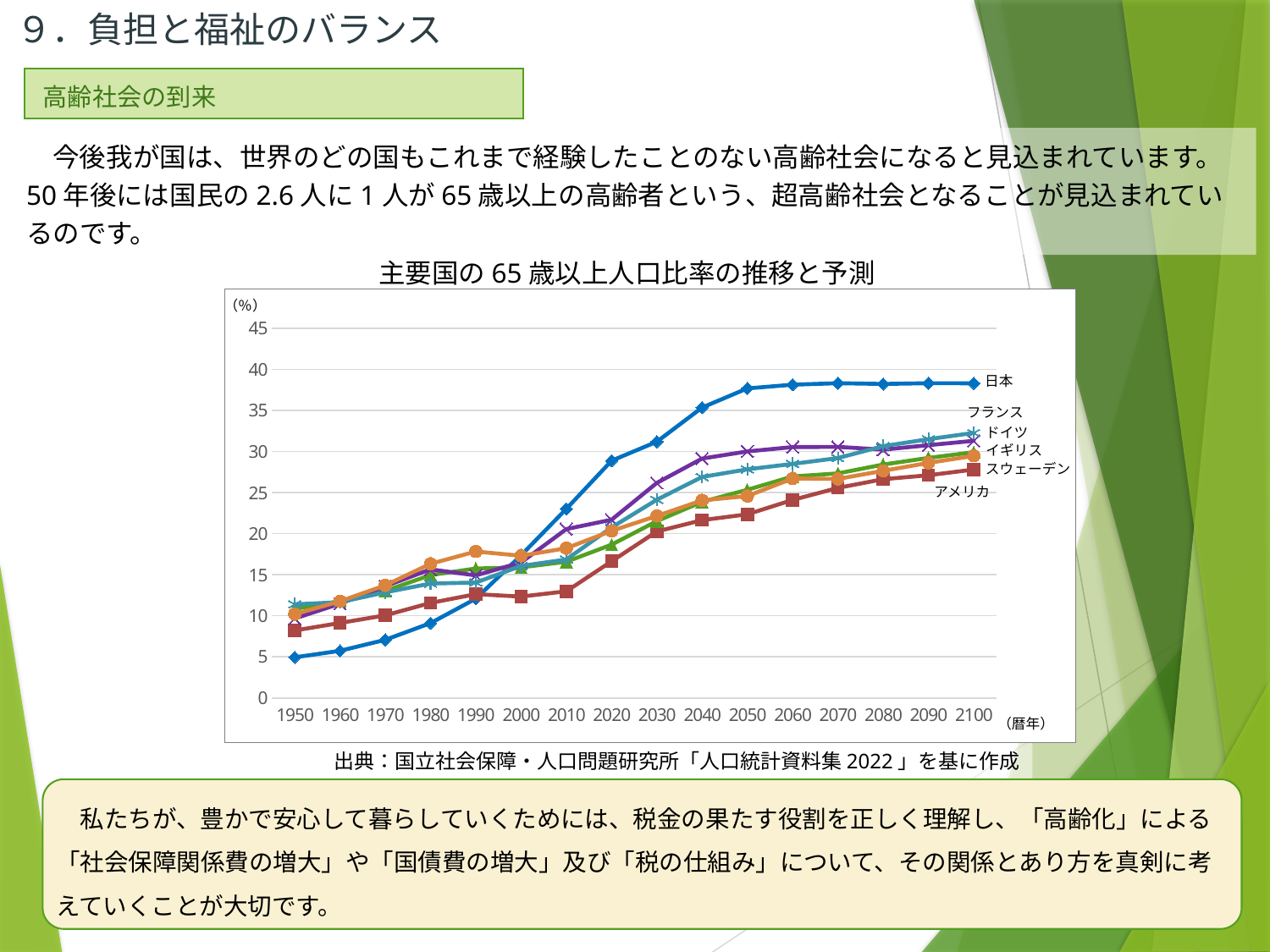
Which is larger in 1950, the value for 日本 or the value for アメリカ? アメリカ Which country has the highest value in 2100? 日本 How many years (points) are shown along the x axis of the chart? 16 Which country has the lowest value in 2100? アメリカ How many countries (series) are plotted in the chart? 6 Which country has the lowest value in 1950? 日本 Is the value for 日本 in 2100 greater or less than 35? greater Is the value for アメリカ in 2100 greater or less than 25? greater Does the value for 日本 rise or fall from 1950 to 2050? rise What kind of chart is shown on the slide? line chart What is the title of the chart? 主要国の65歳以上人口比率の推移と予測 Is the value for 日本 in 1950 greater or less than 10? less